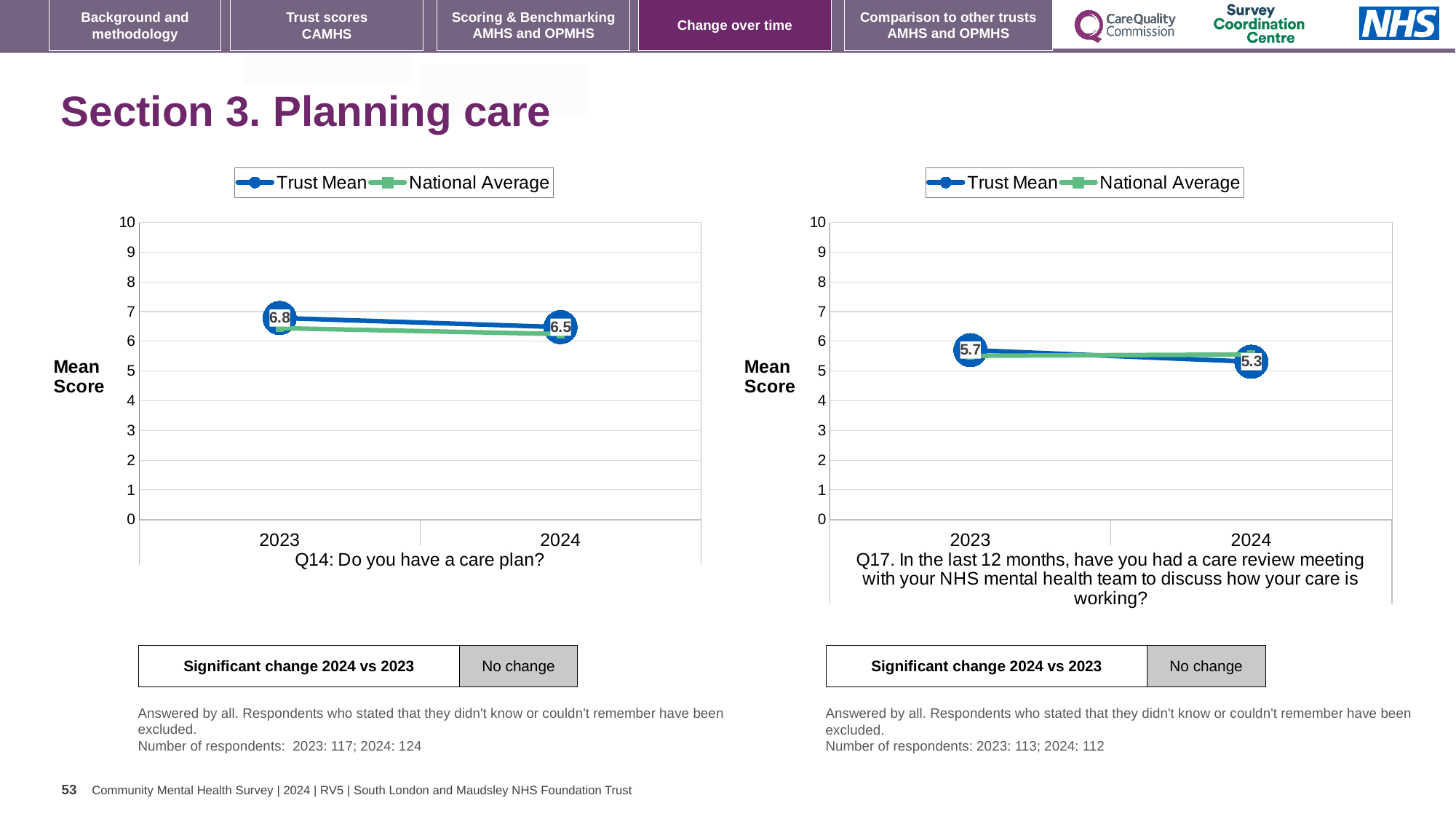
In the Q17 chart (right), what is the difference between the Trust Mean in 2023 and 2024? 0.4 In the Q14 chart (left), what is the Trust Mean score for 2023? 6.8 In the Q17 chart (right), what is the Trust Mean score for 2023? 5.7 In the Q17 chart (right), which year has the higher Trust Mean, 2023 or 2024? 2023 In the Q14 chart (left), is the National Average for 2023 greater or less than 7? less In the Q14 chart (left), does the Trust Mean rise or fall from 2023 to 2024? fall What type of chart is the Q14 chart on the left? line chart In the Q17 chart (right), what is the Trust Mean score for 2024? 5.3 In the Q14 chart (left), by how much did the Trust Mean change from 2023 to 2024? 0.3 In the Q17 chart (right), does the Trust Mean rise or fall from 2023 to 2024? fall How many series does the legend of the Q17 chart (right) list? 2 In the Q14 chart (left), what is the Trust Mean score for 2024? 6.5